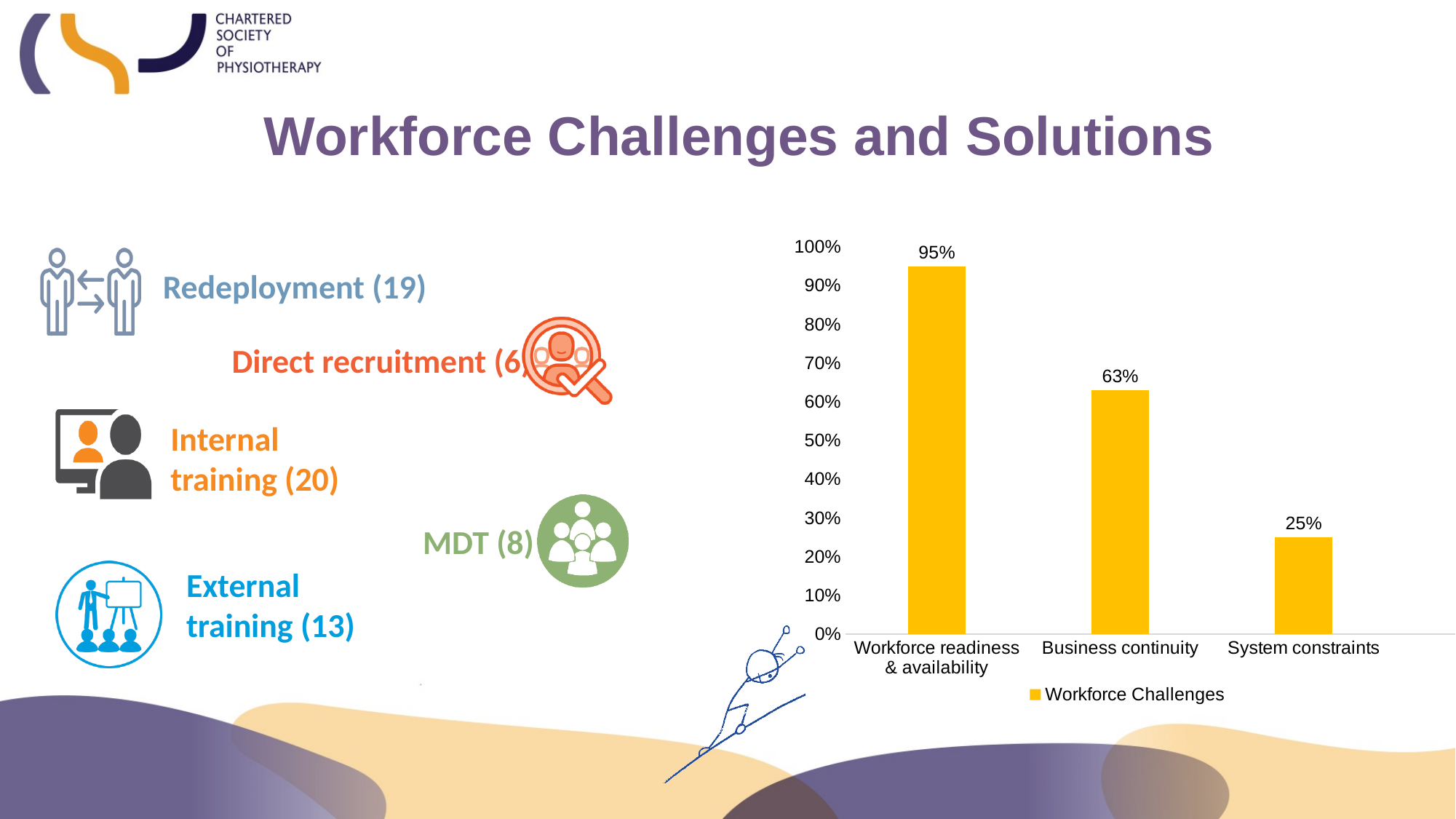
How many categories are shown on the x axis of the chart? 3 Which category has the highest value? Workforce readiness & availability What is the value for Workforce readiness & availability? 95% What is the difference between the values for Workforce readiness & availability and Business continuity? 32% What is the value for Business continuity? 63% Is the value for Business continuity greater or less than 50%? greater Which is larger, the value for Business continuity or the value for System constraints? Business continuity What is the value for System constraints? 25% Which category has the lowest value? System constraints What series name does the chart legend show? Workforce Challenges What kind of chart is shown on the slide? bar chart What is the difference between the values for Business continuity and System constraints? 38%